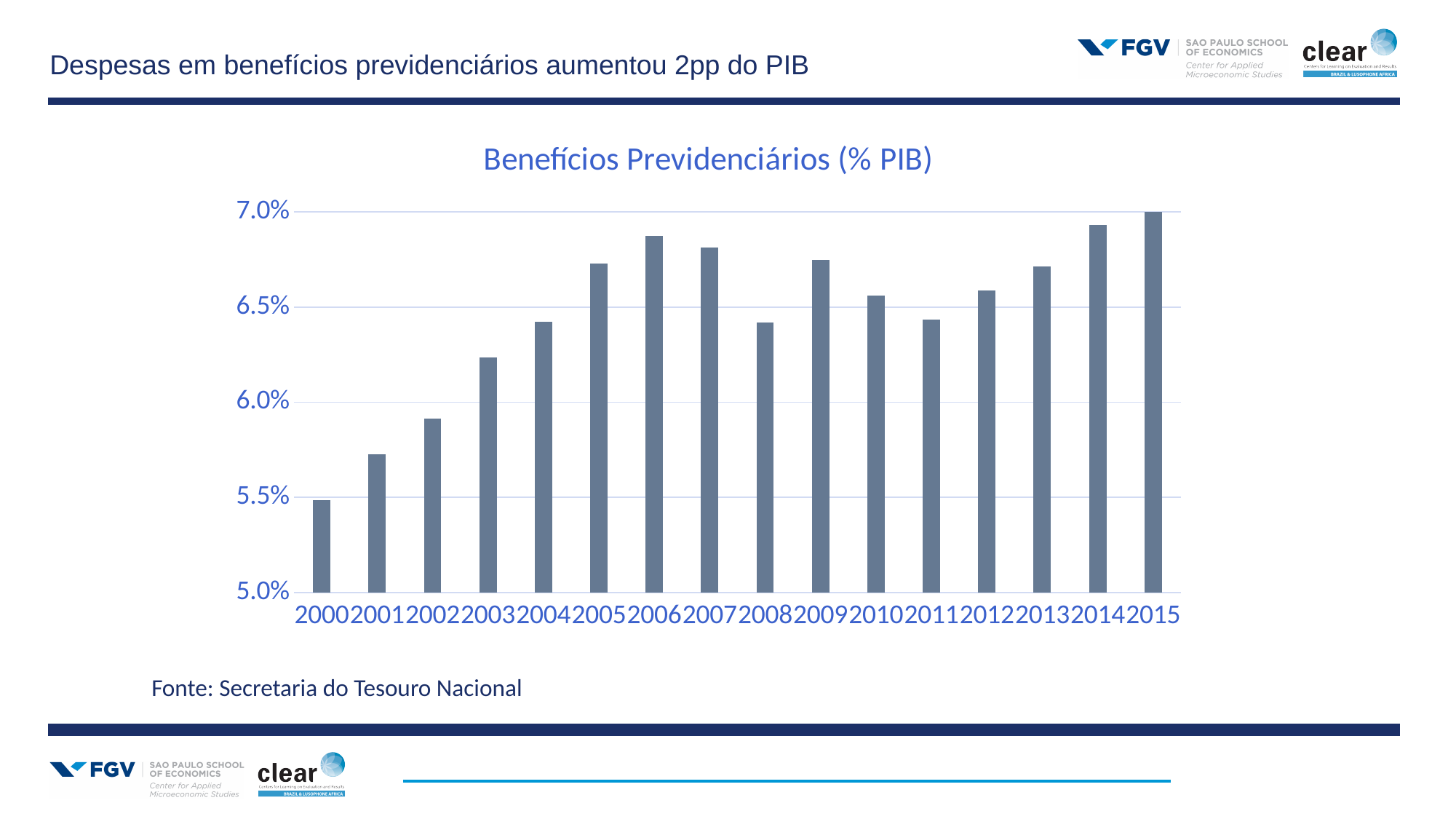
Is the value for 2002 greater or less than 6.0%? less Do the values rise or fall from 2000 to 2006? rise How many years are shown on the x axis of the chart? 16 What kind of chart is shown on the slide? bar chart Which year has the lowest value in the chart? 2000 Is the value for 2008 greater or less than 6.5%? less Which year has the highest value in the chart? 2015 Is the value for 2003 greater or less than 6.0%? greater What is the title of the chart? Benefícios Previdenciários (% PIB) Which year has the larger value, 2006 or 2008? 2006